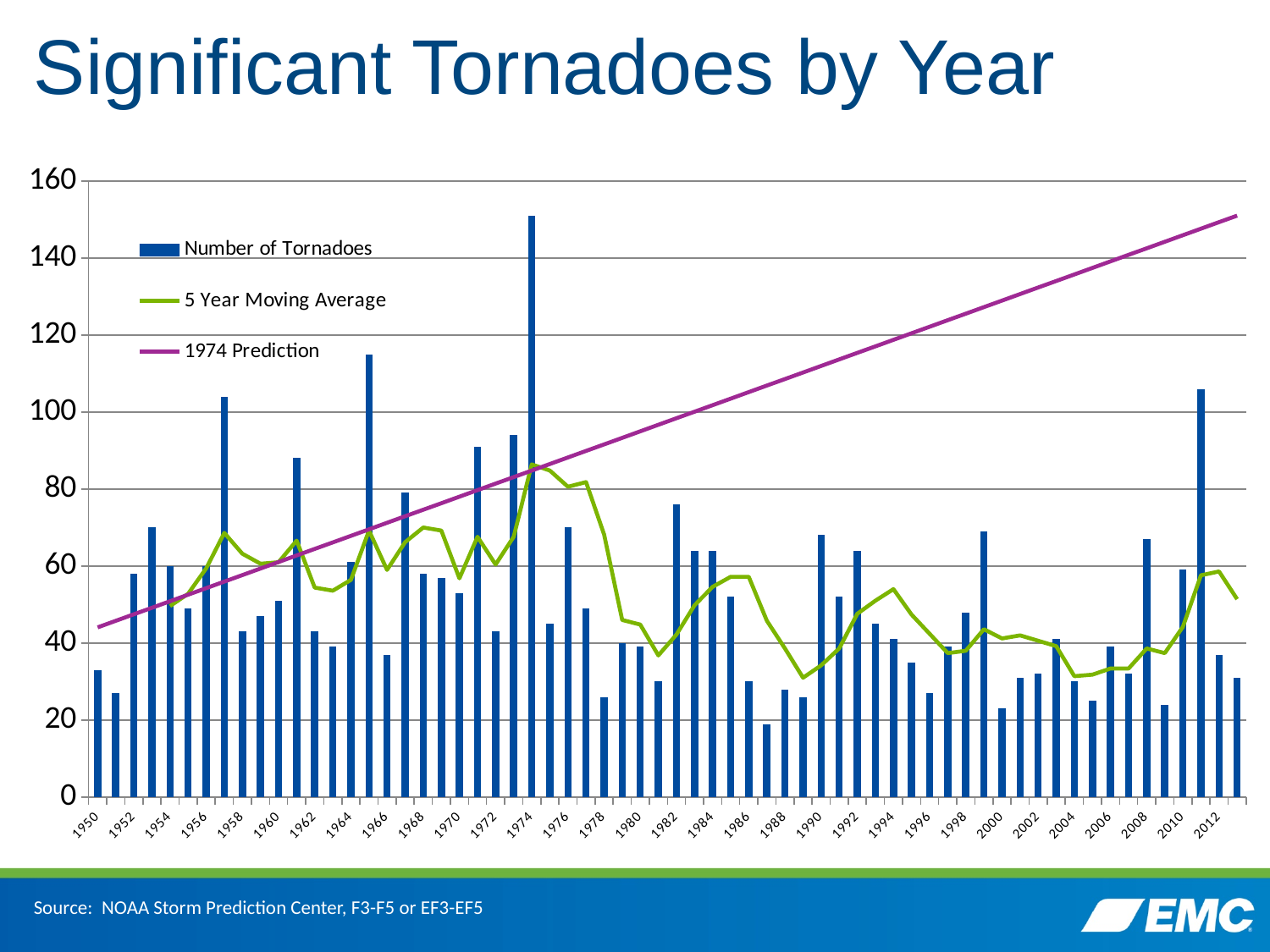
How many series does the legend list? 3 Is the Number of Tornadoes for 1950 greater or less than 40? less Is the Number of Tornadoes for 1965 greater or less than 100? greater Is the Number of Tornadoes for 2011 greater or less than 100? greater What is the name of the series drawn as a green line? 5 Year Moving Average Which year has the larger Number of Tornadoes, 1974 or 2011? 1974 What kind of chart is used to show the Number of Tornadoes series? bar chart Which year has the highest Number of Tornadoes? 1974 Which year has the larger Number of Tornadoes, 1961 or 1982? 1961 Does the 1974 Prediction line rise or fall from left to right across the years? rises